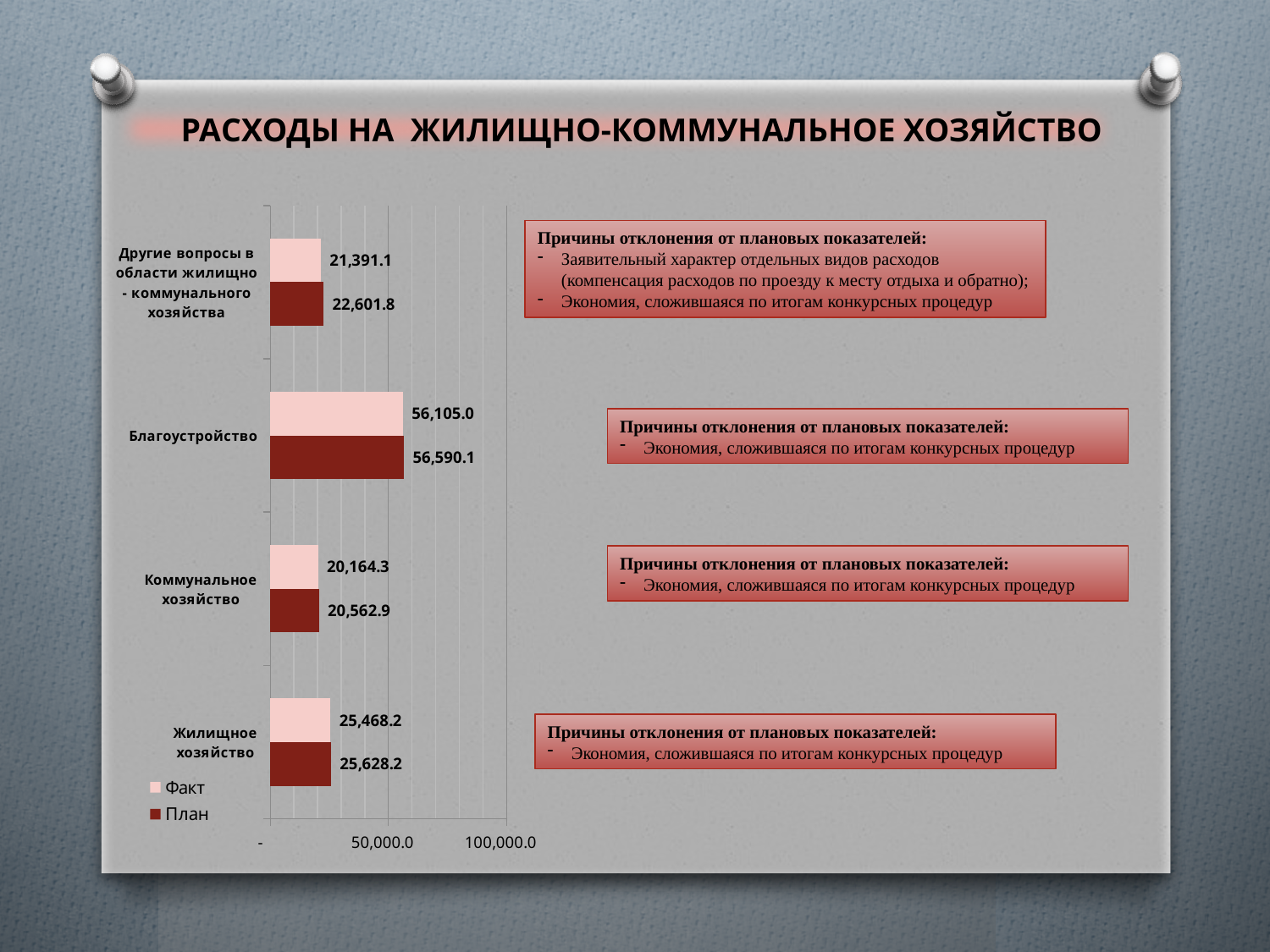
Which category has the highest План value? Благоустройство How many series does the legend list? 2 What is the План value for Жилищное хозяйство? 25,628.2 How many categories are shown in the chart? 4 What is the План value for Коммунальное хозяйство? 20,562.9 For Другие вопросы в области жилищно-коммунального хозяйства, which is larger: the Факт value or the План value? План What is the difference between the План and Факт values for Жилищное хозяйство? 160.0 What is the difference between the План and Факт values for Благоустройство? 485.1 What is the Факт value for Благоустройство? 56,105.0 What is the Факт value for Другие вопросы в области жилищно-коммунального хозяйства? 21,391.1 Is the План value for Благоустройство greater or less than 50,000.0? greater Which category has the lowest Факт value? Коммунальное хозяйство